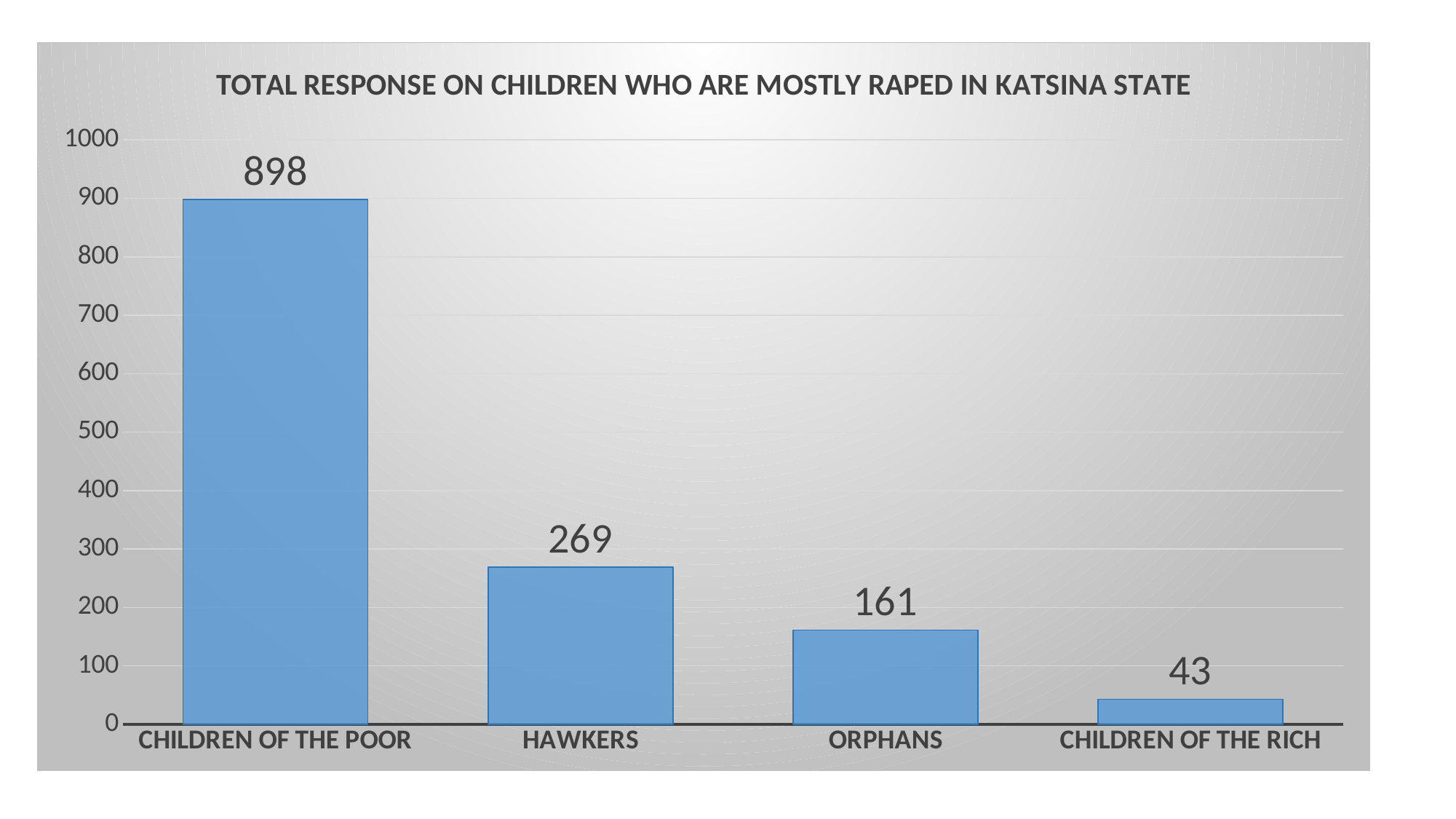
What is the value for ORPHANS? 161 What is the value for CHILDREN OF THE POOR? 898 What is the title of the chart? TOTAL RESPONSE ON CHILDREN WHO ARE MOSTLY RAPED IN KATSINA STATE Which category has the highest value? CHILDREN OF THE POOR What is the value for CHILDREN OF THE RICH? 43 What is the difference between the values for CHILDREN OF THE POOR and HAWKERS? 629 What is the difference between the values for ORPHANS and CHILDREN OF THE RICH? 118 How many categories are shown on the x axis? 4 Which is larger, the value for HAWKERS or the value for ORPHANS? HAWKERS What kind of chart is shown on the slide? Bar chart What is the value for HAWKERS? 269 Which category has the lowest value? CHILDREN OF THE RICH